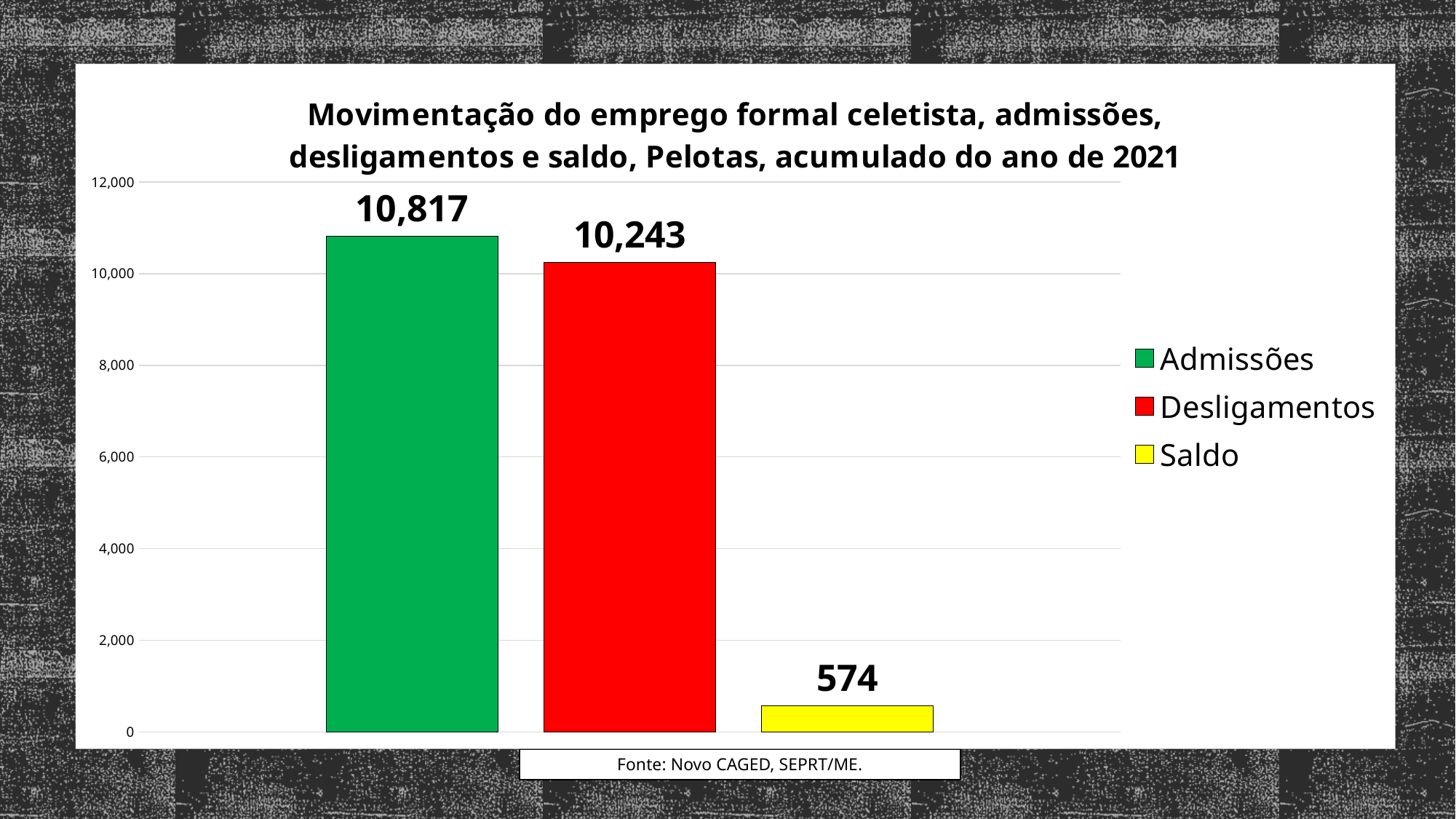
What is the value for Desligamentos? 10,243 Which series has the lowest value? Saldo What colour is the bar for Saldo? yellow How many series does the legend list? 3 What is the value for Admissões? 10,817 What is the difference between Admissões and Desligamentos? 574 Which series has the highest value? Admissões What kind of chart is shown on the slide? bar chart Is the value for Desligamentos greater or less than 10,000? greater Which is larger, Admissões or Desligamentos? Admissões What is the value for Saldo? 574 Is the value for Saldo greater or less than 2,000? less